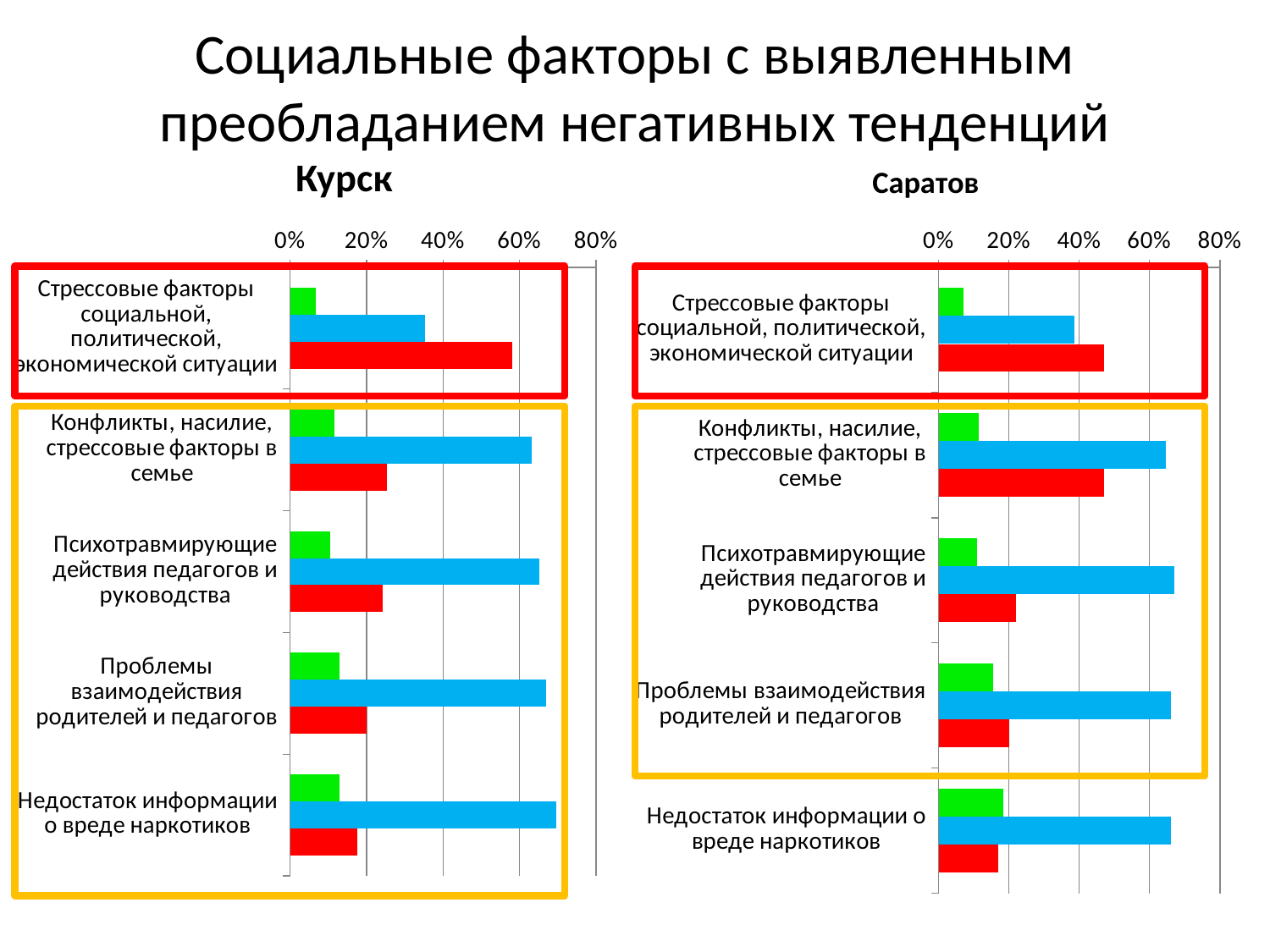
On the Саратов chart, for 'Конфликты, насилие, стрессовые факторы в семье', which bar is longer, the blue one or the red one? the blue one On the Саратов chart, is the blue bar for 'Стрессовые факторы социальной, политической, экономической ситуации' greater or less than 60%? less How many categories are shown on the Саратов chart? 5 What is the title of the chart on the right side of the slide? Саратов On the Курск chart, which category has the longest red bar? Стрессовые факторы социальной, политической, экономической ситуации On the Курск chart, which category has the shortest blue bar? Стрессовые факторы социальной, политической, экономической ситуации How many categories are shown on the Курск chart? 5 On the Курск chart, for 'Стрессовые факторы социальной, политической, экономической ситуации', which bar is longer, the red one or the blue one? the red one What kind of chart is the Курск chart? bar chart On the Курск chart, is the red bar for 'Стрессовые факторы социальной, политической, экономической ситуации' greater or less than 40%? greater On the Саратов chart, is the red bar for 'Психотравмирующие действия педагогов и руководства' greater or less than 40%? less